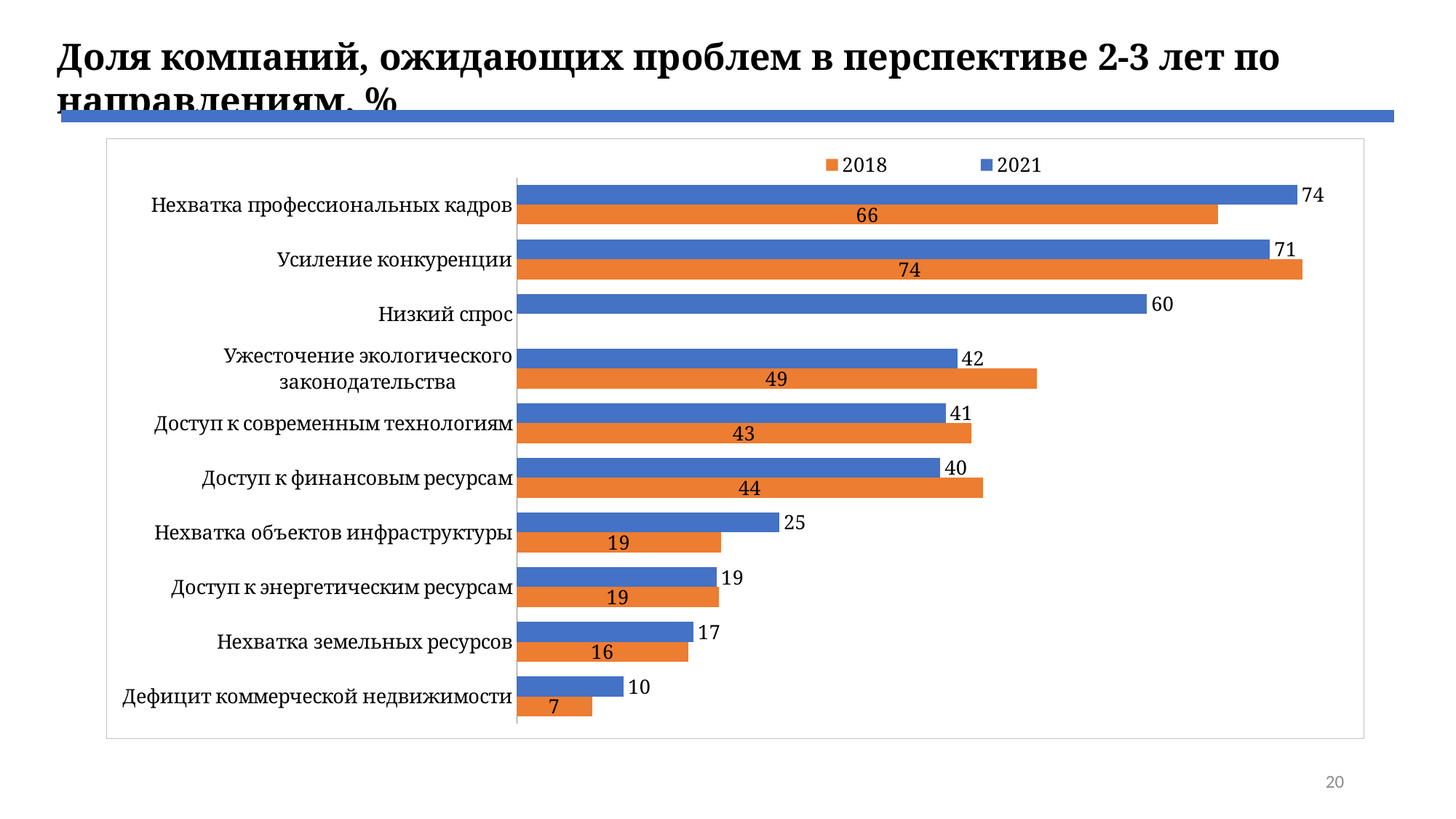
Which colour represents the 2018 series in the legend? Orange Which category has the lowest 2018 value? Дефицит коммерческой недвижимости What is the 2018 value for «Усиление конкуренции»? 74 How many series does the legend list? 2 What type of chart is shown on the slide? Bar chart What is the 2021 value for «Низкий спрос»? 60 What is the difference between the 2021 and 2018 values for «Нехватка профессиональных кадров»? 8 Which category has the highest 2021 value? Нехватка профессиональных кадров What is the 2021 value for «Нехватка профессиональных кадров»? 74 What is the 2018 value for «Ужесточение экологического законодательства»? 49 How many categories are shown on the chart? 10 For «Доступ к финансовым ресурсам», which is larger: the 2018 value or the 2021 value? 2018